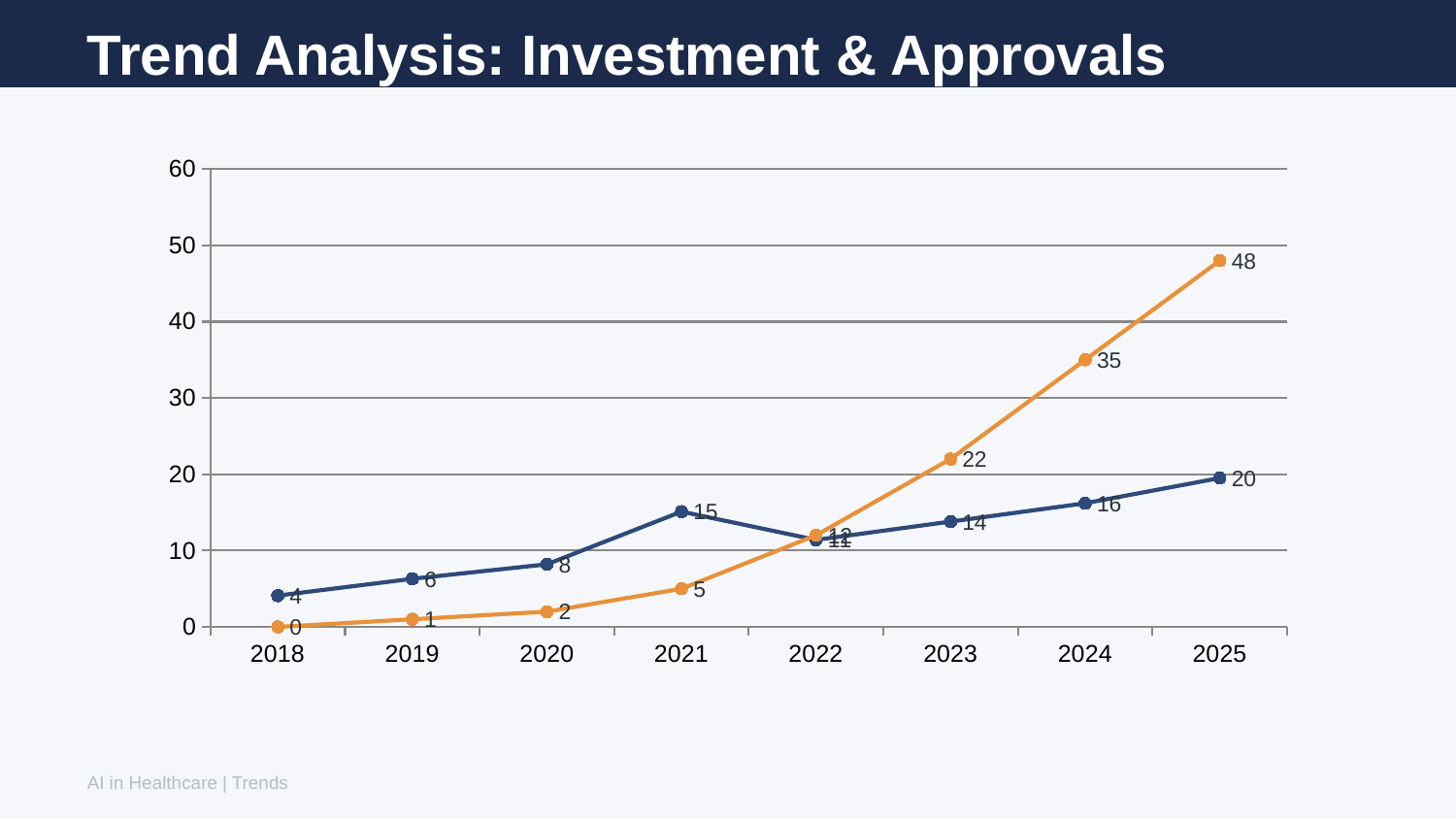
What is the value of the blue line in 2021? 15 What is the difference between the orange line and the blue line in 2025? 28 What is the value of the orange line in 2025? 48 In 2023, which line has the higher value, the orange line or the blue line? orange line What type of chart is shown on the slide? line chart Does the orange line rise or fall from 2018 to 2025? rise What is the value of the orange line in 2018? 0 In which year does the blue line have its lowest value? 2018 In which year does the orange line reach its highest value? 2025 What is the title of the slide? Trend Analysis: Investment & Approvals In 2019, which line has the higher value, the blue line or the orange line? blue line How many years are shown on the x axis? 8